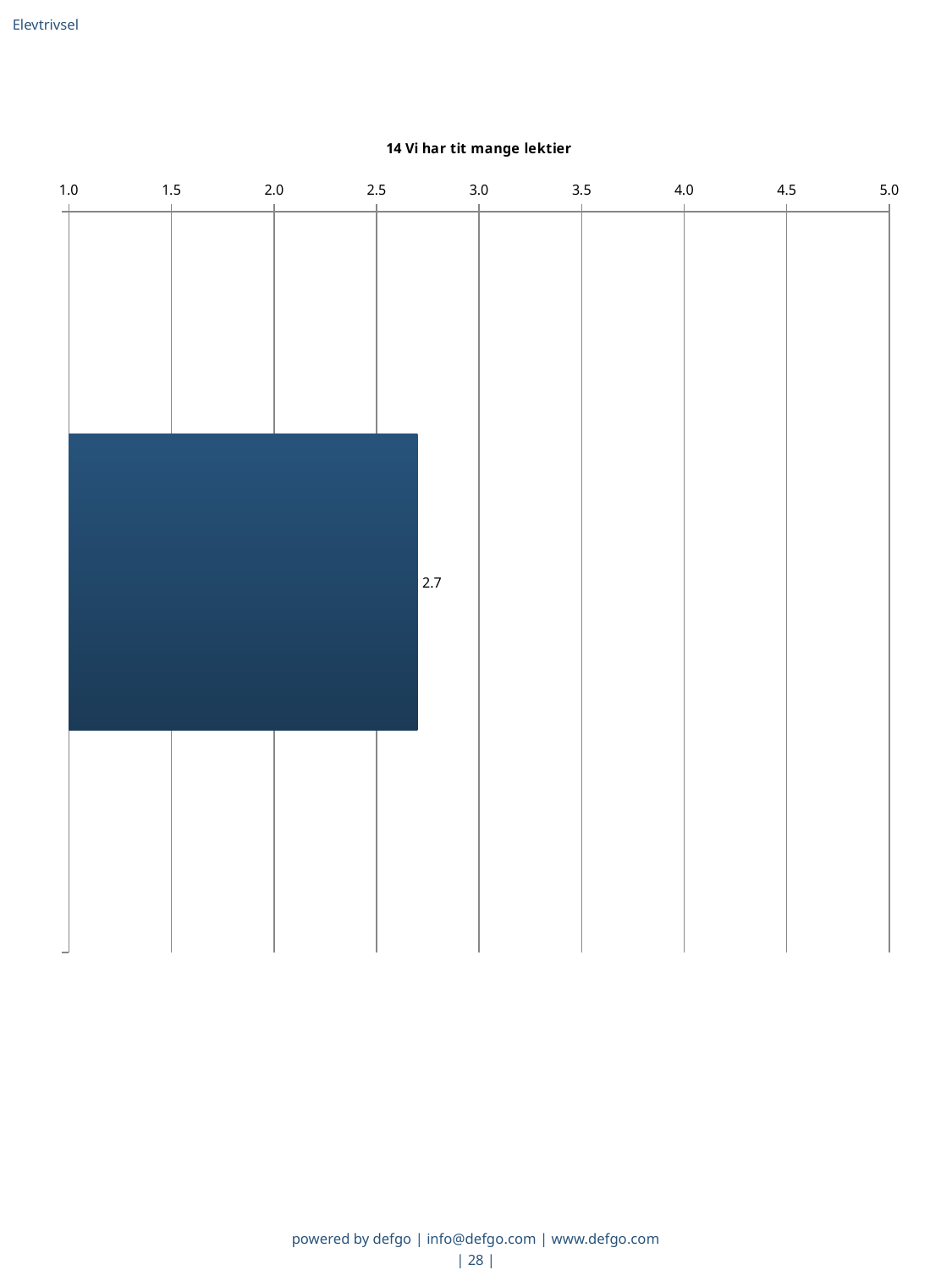
How many bars are plotted in the chart? 1 Is the value of the bar greater or less than 2.5? greater What is the highest value shown on the horizontal axis? 5.0 What is the title of the chart? 14 Vi har tit mange lektier What value is shown by the data label on the bar? 2.7 What is the lowest value shown on the horizontal axis? 1.0 Is the value of the bar greater or less than 3.0? less What kind of chart is shown on the slide? bar chart